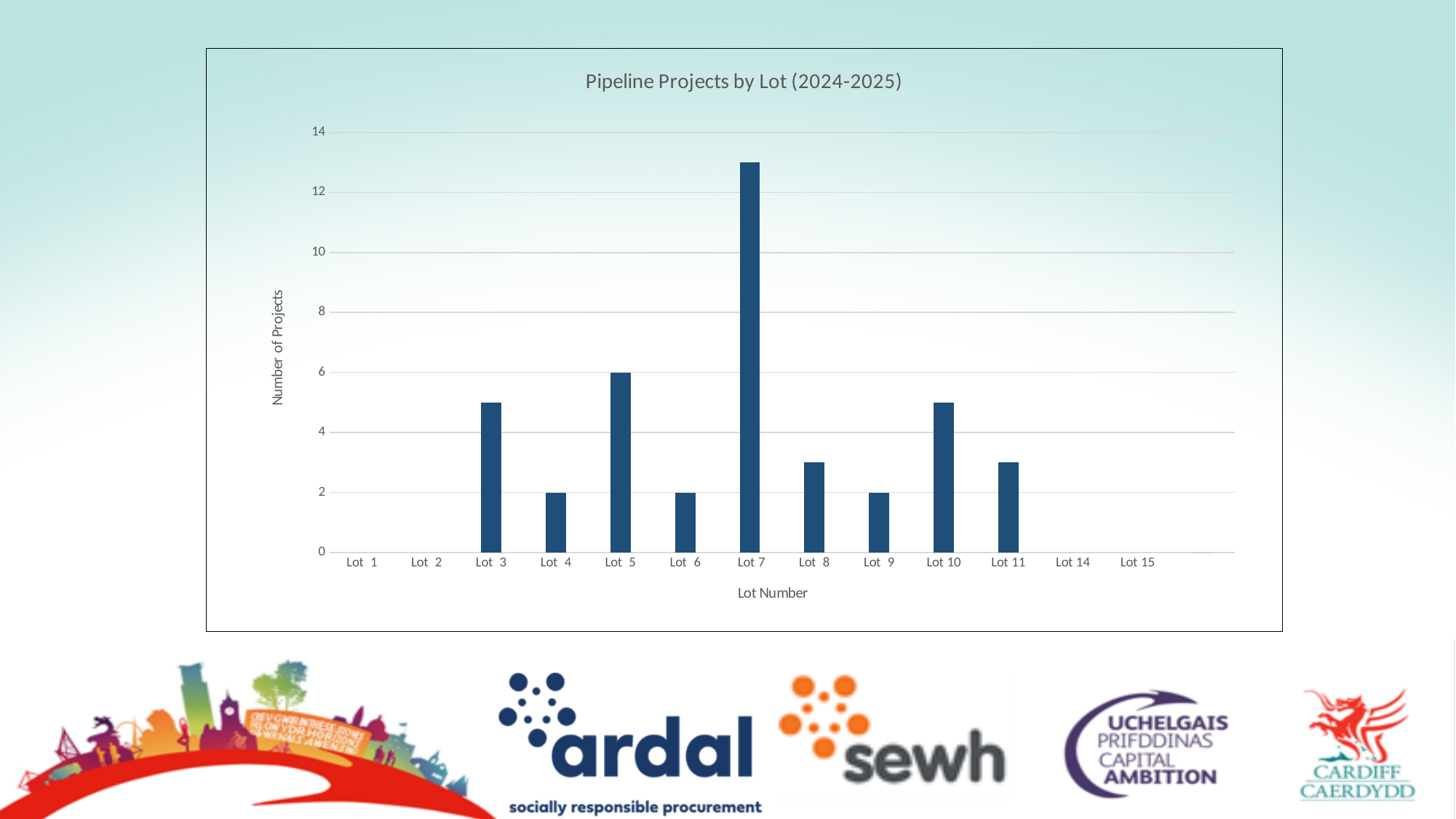
What is the difference between the number of projects for Lot 5 and Lot 6? 4 What is the label on the vertical axis of the chart? Number of Projects How many projects are shown for Lot 9? 2 What type of chart is shown on the slide? Bar chart Is the value for Lot 8 greater or less than 4? less How many projects are shown for Lot 5? 6 How many lot categories are shown on the x axis? 13 Is the value for Lot 7 greater or less than 12? greater Which lot has the highest number of pipeline projects? Lot 7 What is the title of the chart? Pipeline Projects by Lot (2024-2025) How many projects are shown for Lot 4? 2 Which has more projects, Lot 10 or Lot 11? Lot 10